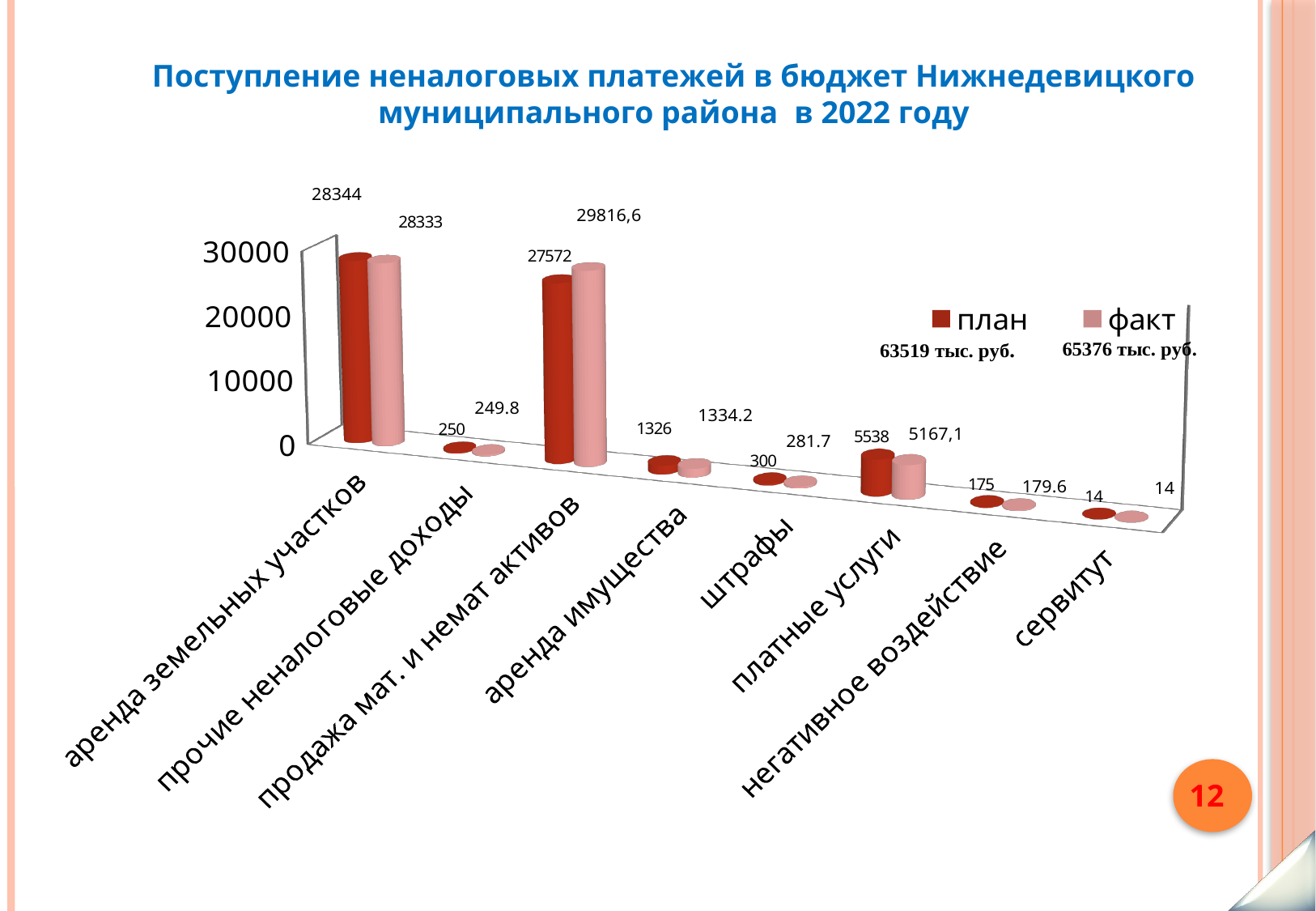
What total is shown next to the факт legend entry? 65376 тыс. руб. What is the план value for штрафы? 300 How many series does the legend list? 2 Which category has the highest факт value? продажа мат. и немат активов What is the difference between the факт and план values for платные услуги? 370,9 What kind of chart is shown on the slide? bar chart What is the факт value for платные услуги? 5167,1 What is the факт value for продажа мат. и немат активов? 29816,6 What is the план value for аренда земельных участков? 28344 Which category has the lowest план value? сервитут How many categories are shown on the x axis? 8 Which is larger for аренда имущества: the план value or the факт value? факт